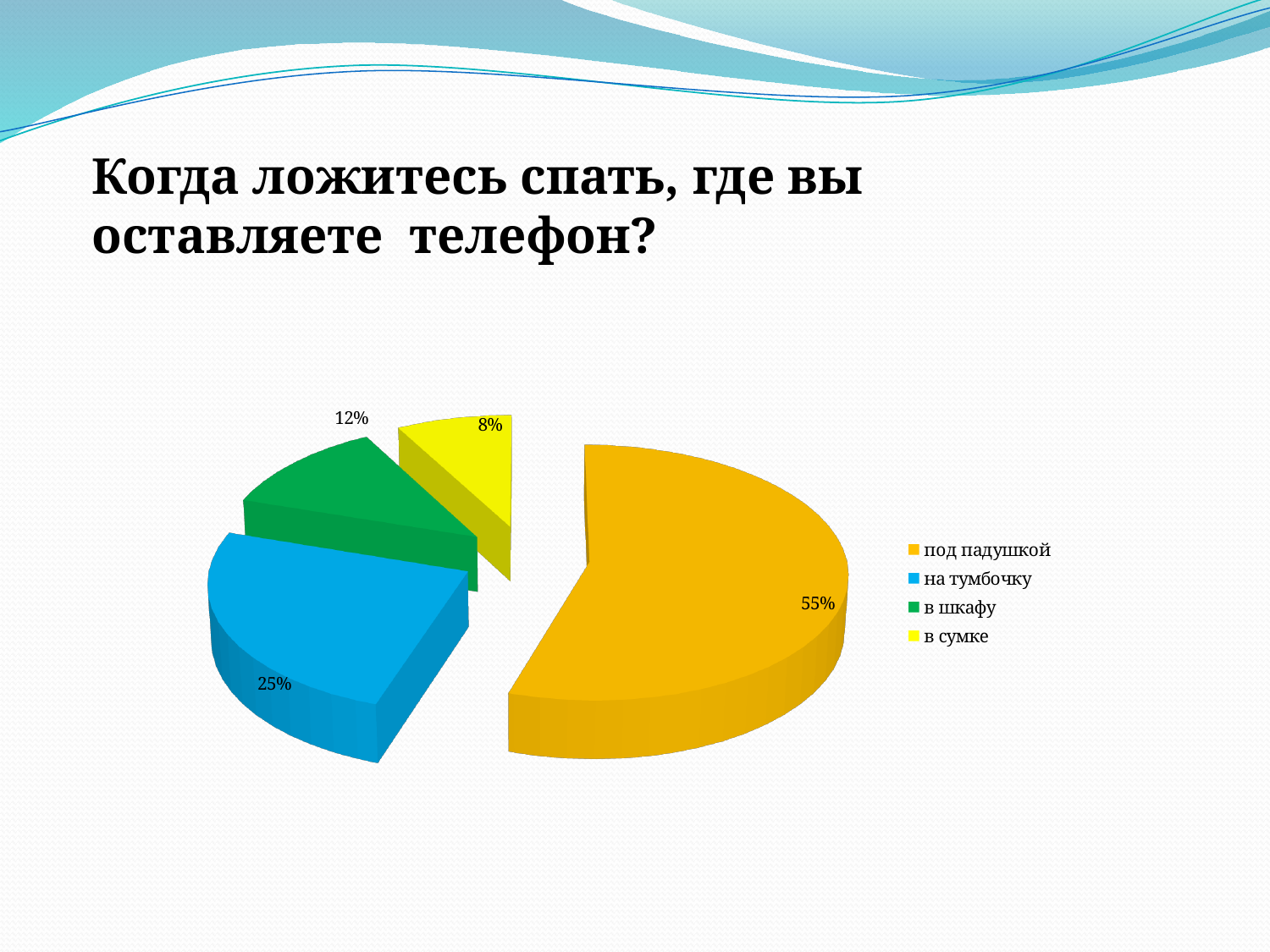
Which is larger, the value for "на тумбочку" or the value for "в шкафу"? на тумбочку Which category has the largest slice? под падушкой What is the difference between the values for "под падушкой" and "на тумбочку"? 30% Which category has the smallest slice? в сумке What share of the pie does "под падушкой" take? 55% What is the difference between the values for "в шкафу" and "в сумке"? 4% Which colour represents "в шкафу" in the legend? green What is the value for "в шкафу"? 12% What is the value for "на тумбочку"? 25% How many categories does the pie chart show? 4 What is the value for "в сумке"? 8% What kind of chart is shown on the slide? pie chart